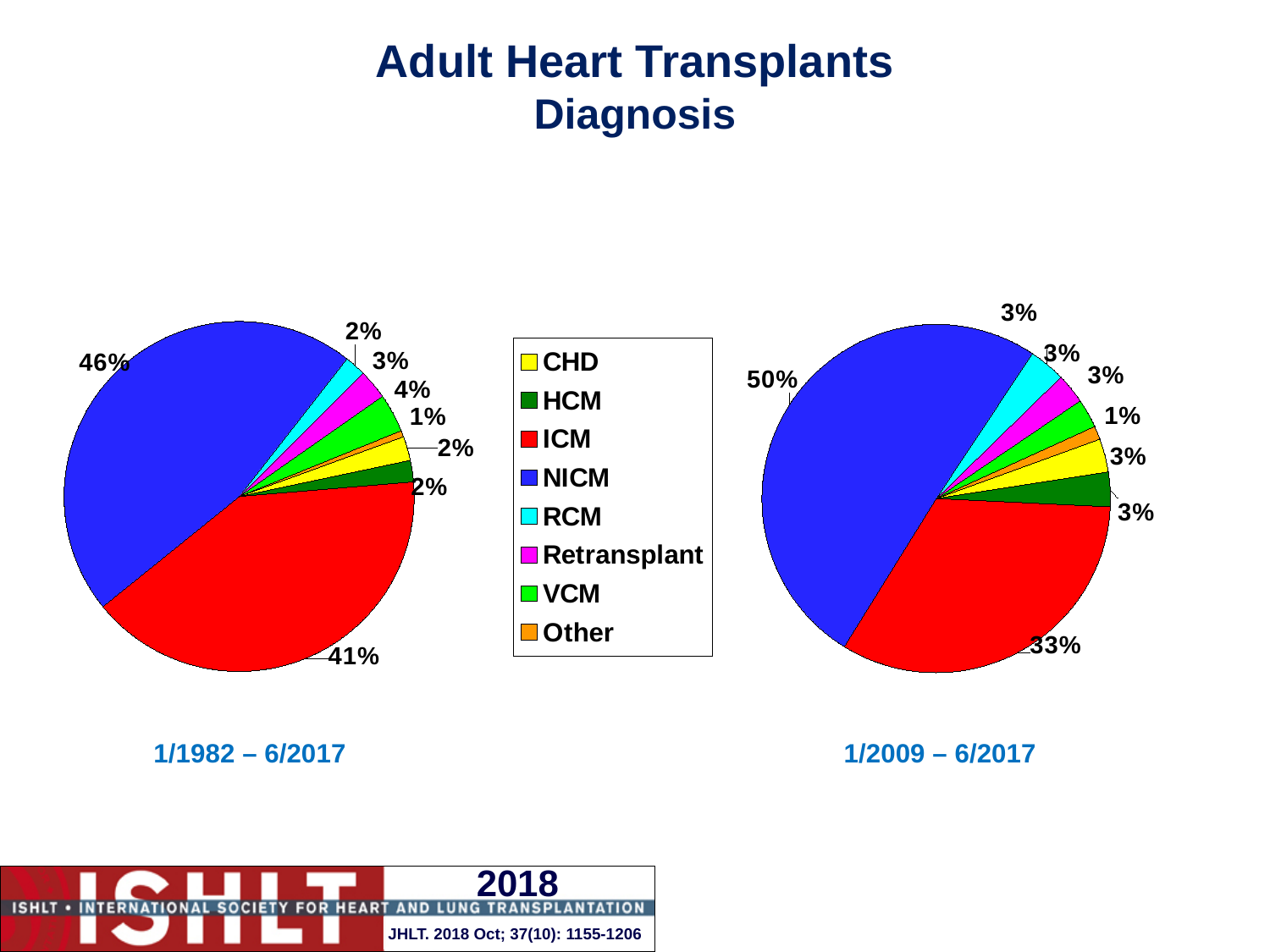
In the 1/1982 – 6/2017 pie chart, what share is labelled for the NICM slice? 46% In the 1/2009 – 6/2017 pie chart, which diagnosis has the smallest slice? Other In the 1/2009 – 6/2017 pie chart, what share is labelled for the NICM slice? 50% What type of chart is used on this slide? Pie chart In the 1/1982 – 6/2017 pie chart, what is the difference between the NICM share and the ICM share? 5% How many diagnosis categories does the legend list? 8 In the 1/1982 – 6/2017 pie chart, what share is labelled for the VCM slice? 4% In the 1/2009 – 6/2017 pie chart, what share is labelled for the ICM slice? 33% In the 1/2009 – 6/2017 pie chart, which is larger, the NICM slice or the ICM slice? NICM In the 1/1982 – 6/2017 pie chart, which diagnosis has the largest slice? NICM In the 1/2009 – 6/2017 pie chart, what share is labelled for the Other slice? 1% In the 1/1982 – 6/2017 pie chart, what share is labelled for the ICM slice? 41%